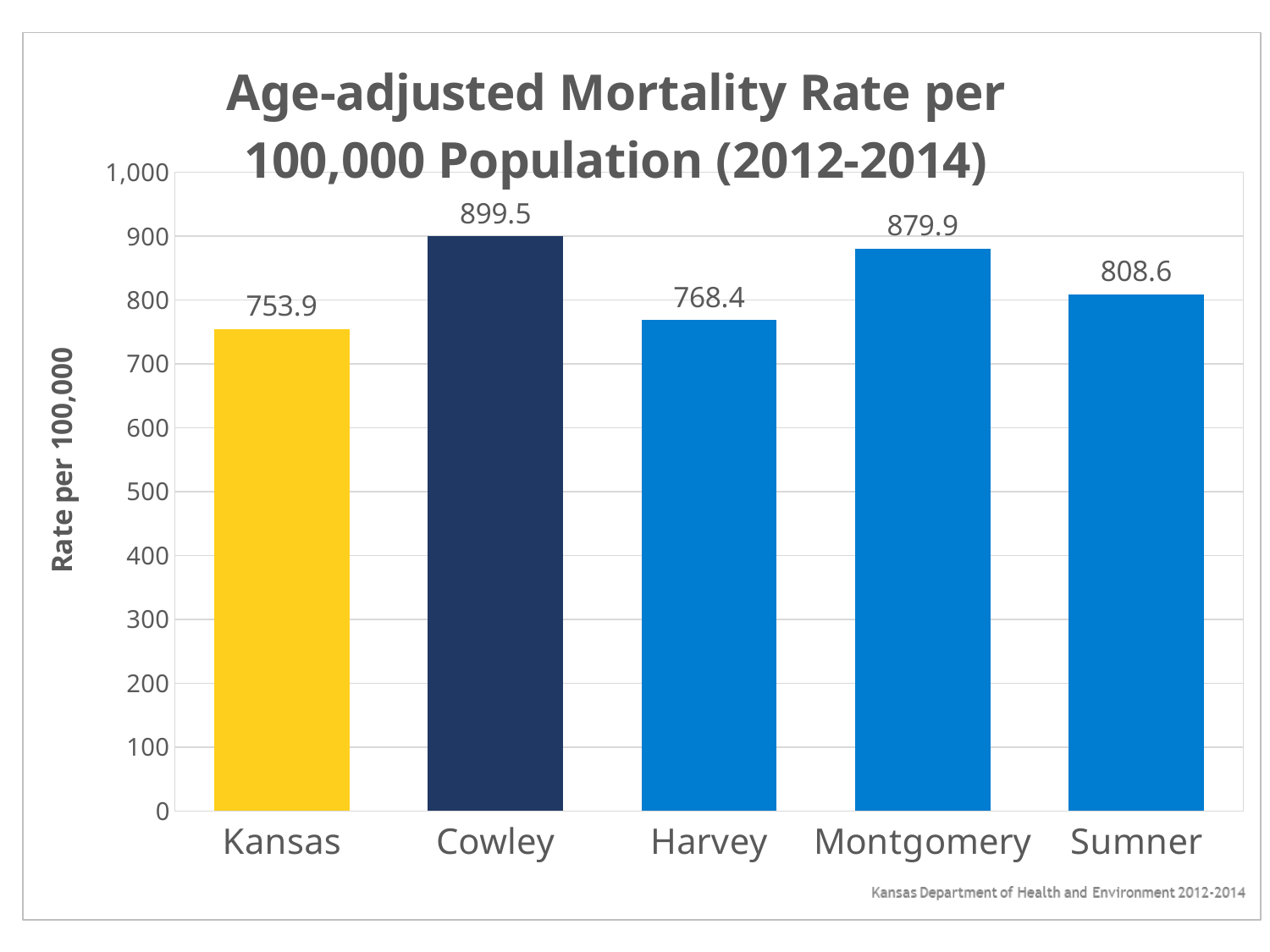
What kind of chart is shown on the slide? Bar chart What is the age-adjusted mortality rate per 100,000 population for Cowley? 899.5 Which category has the lowest age-adjusted mortality rate? Kansas What is the difference between the mortality rates for Montgomery and Harvey? 111.5 What is the age-adjusted mortality rate per 100,000 population for Sumner? 808.6 What is the label of the vertical axis? Rate per 100,000 What is the difference between the mortality rates for Cowley and Kansas? 145.6 What is the age-adjusted mortality rate per 100,000 population for Kansas? 753.9 Is the value for Harvey greater or less than 800? less Which has a higher age-adjusted mortality rate, Montgomery or Sumner? Montgomery Which category has the highest age-adjusted mortality rate? Cowley How many categories are shown on the x axis of the chart? 5